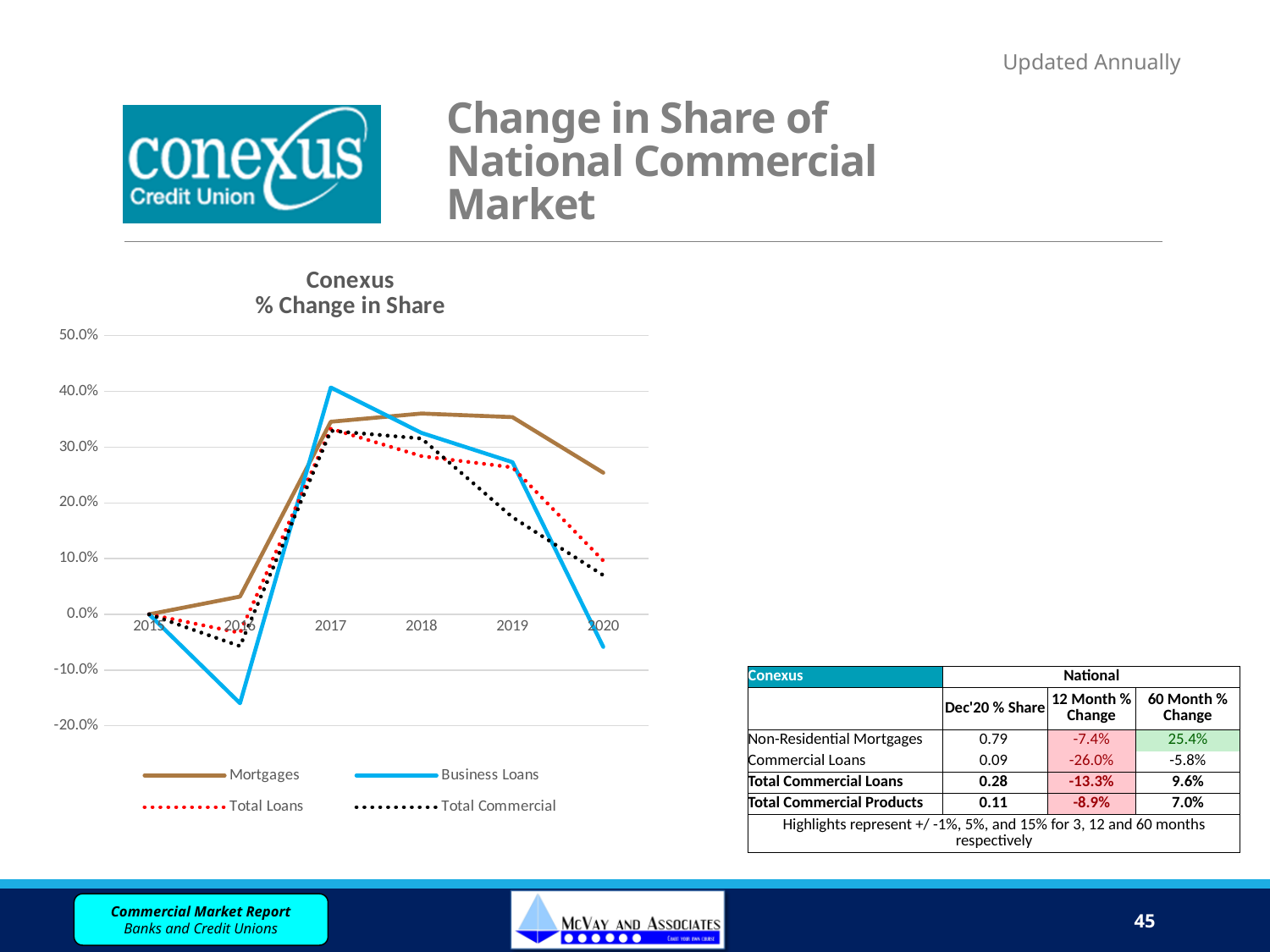
Which series has the highest value in 2020 in the "Conexus % Change in Share" chart? Mortgages Does the Mortgages line rise or fall from 2018 to 2020? fall Is the value for Mortgages in 2020 greater or less than 20.0%? greater Which series has the lowest value in 2020 in the "Conexus % Change in Share" chart? Business Loans How many years are shown on the x axis of the "Conexus % Change in Share" chart? 6 How many series does the legend of the "Conexus % Change in Share" chart list? 4 Which series is plotted with a solid blue line in the "Conexus % Change in Share" chart? Business Loans What kind of chart is the "Conexus % Change in Share" chart? line chart Is the value for Business Loans in 2020 greater or less than 0.0%? less Which series has the lowest value in 2016 in the "Conexus % Change in Share" chart? Business Loans Which series has the highest value in 2017 in the "Conexus % Change in Share" chart? Business Loans Is the value for Business Loans in 2016 greater or less than -10.0%? less